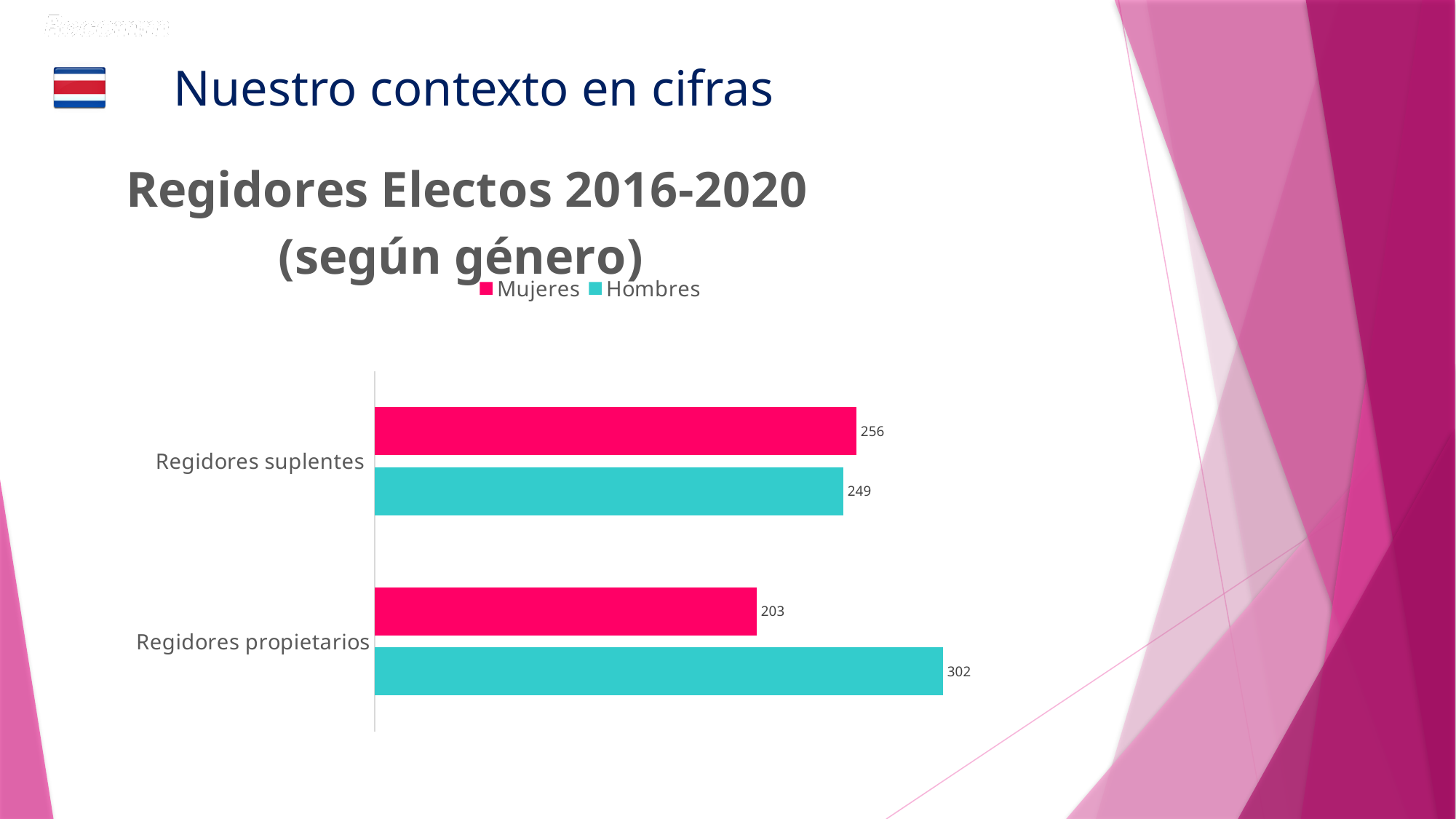
What is the value for Mujeres in the Regidores suplentes category? 256 Which bar has the highest value on the chart? Hombres, Regidores propietarios Which bar has the lowest value on the chart? Mujeres, Regidores propietarios What is the value for Hombres in the Regidores suplentes category? 249 What is the value for Mujeres in the Regidores propietarios category? 203 What kind of chart is shown on the slide? Bar chart What is the difference between Mujeres and Hombres in the Regidores suplentes category? 7 What is the difference between Hombres and Mujeres in the Regidores propietarios category? 99 How many categories are shown on the chart? 2 In the Regidores propietarios category, which is larger, Mujeres or Hombres? Hombres What is the value for Hombres in the Regidores propietarios category? 302 How many series does the legend list? 2